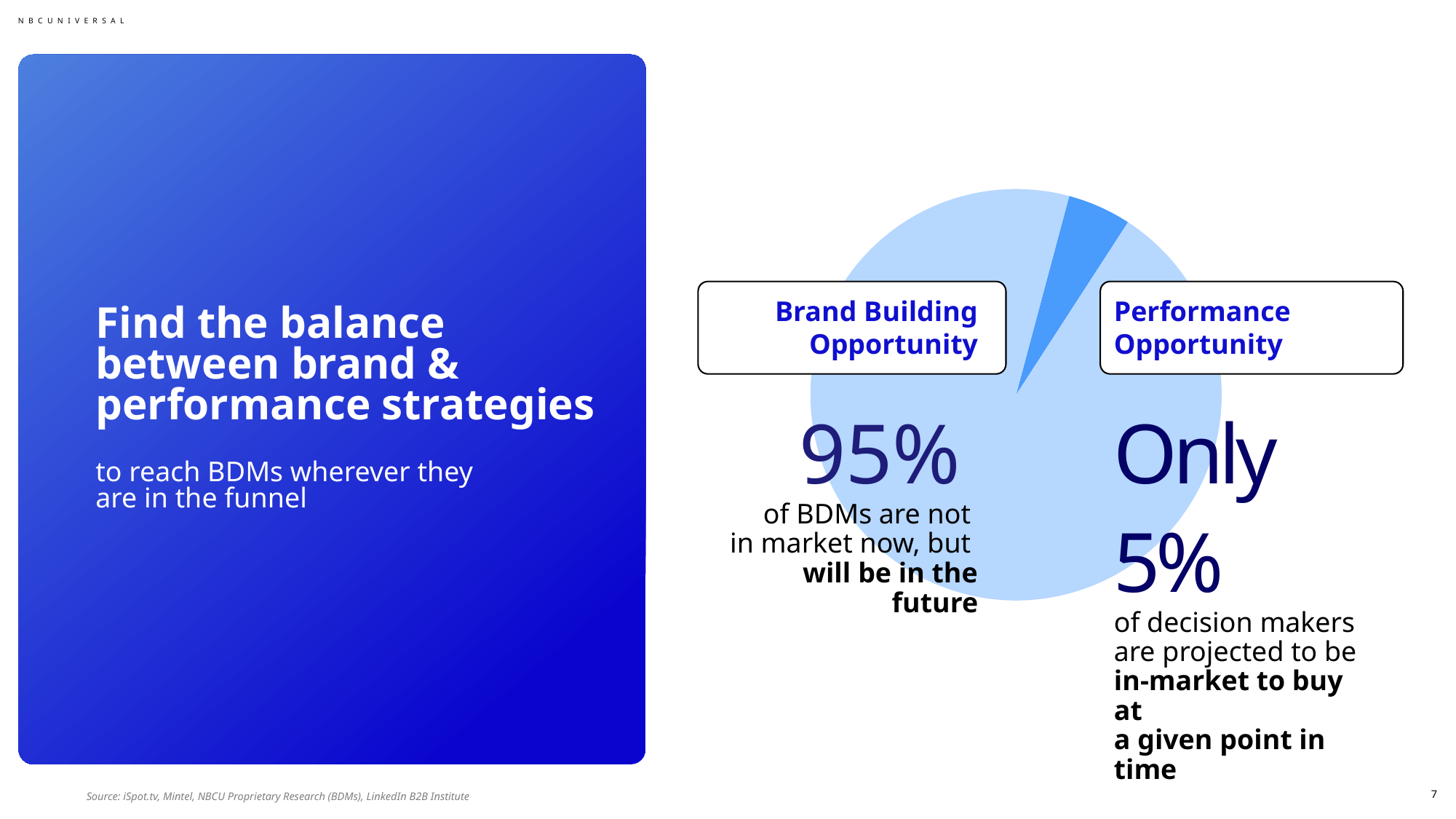
What is the difference in percentage points between the Brand Building Opportunity share and the Performance Opportunity share? 90 Which slice of the pie is drawn in the darker blue colour? Performance Opportunity What share of the pie corresponds to the Brand Building Opportunity? 95% What share of the pie corresponds to the Performance Opportunity? 5% What kind of chart is shown on the slide? pie chart Which slice of the pie is the largest? Brand Building Opportunity How many slices does the pie chart have? 2 Which slice of the pie is the smallest? Performance Opportunity What percentage of BDMs are not in market now but will be in the future? 95% What do the two slices of the pie chart add up to? 100% What percentage of decision makers are projected to be in-market to buy at a given point in time? 5% Which is larger, the Brand Building Opportunity share or the Performance Opportunity share? Brand Building Opportunity